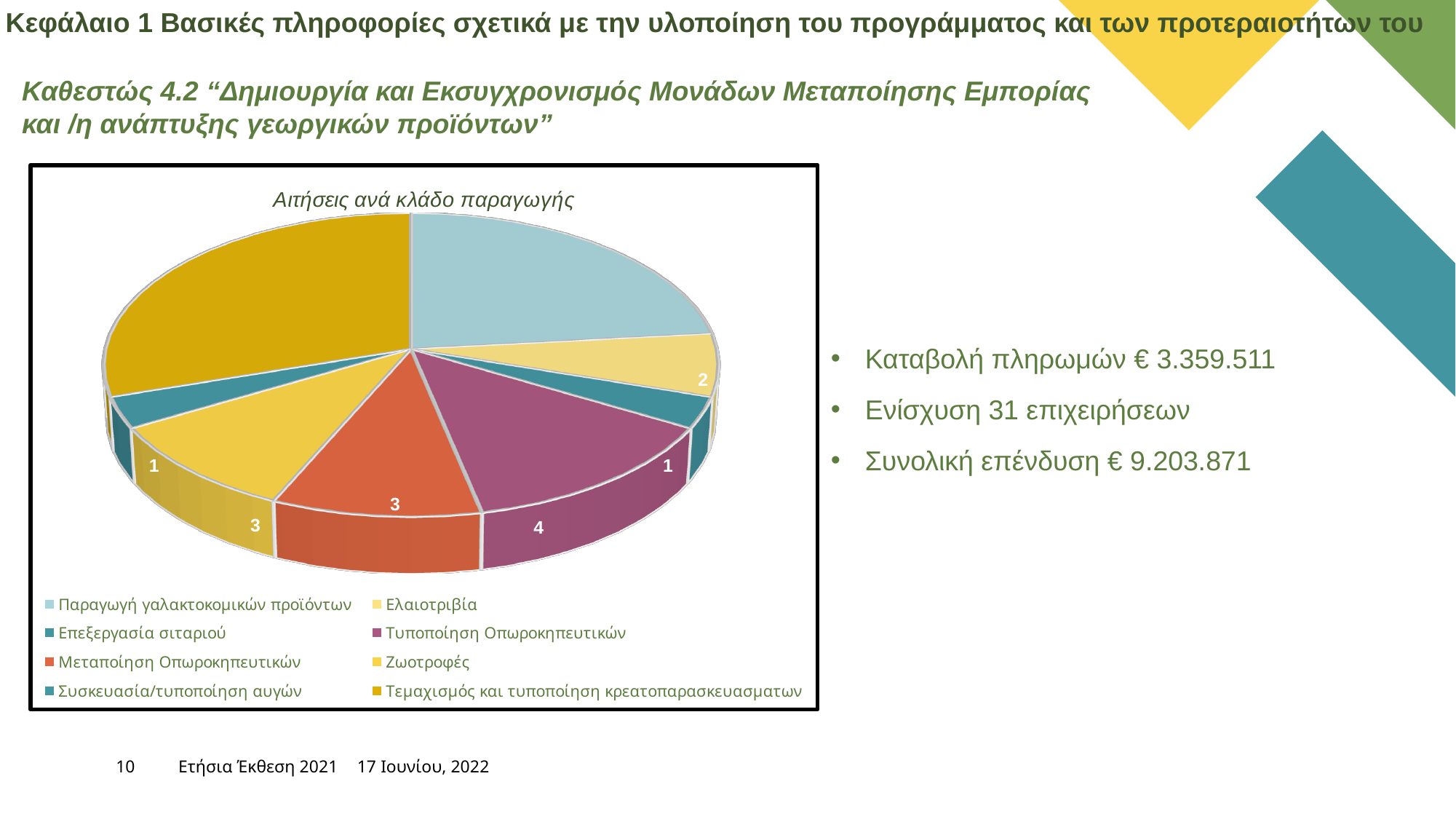
What is the title of the chart? Αιτήσεις ανά κλάδο παραγωγής How many categories does the chart's legend list? 8 What colour is the slice for Μεταποίηση Οπωροκηπευτικών? orange What is the difference between the values for Τυποποίηση Οπωροκηπευτικών and Ελαιοτριβία? 2 What is the value shown for Επεξεργασία σιταριού? 1 What kind of chart is shown on the slide? pie chart Which has the larger value, Τυποποίηση Οπωροκηπευτικών or Ελαιοτριβία? Τυποποίηση Οπωροκηπευτικών What is the value shown for Τυποποίηση Οπωροκηπευτικών? 4 What is the value shown for Μεταποίηση Οπωροκηπευτικών? 3 What is the value shown for Ελαιοτριβία? 2 Which category has the largest slice in the pie chart? Τεμαχισμός και τυποποίηση κρεατοπαρασκευασματων What is the value shown for Ζωοτροφές? 3